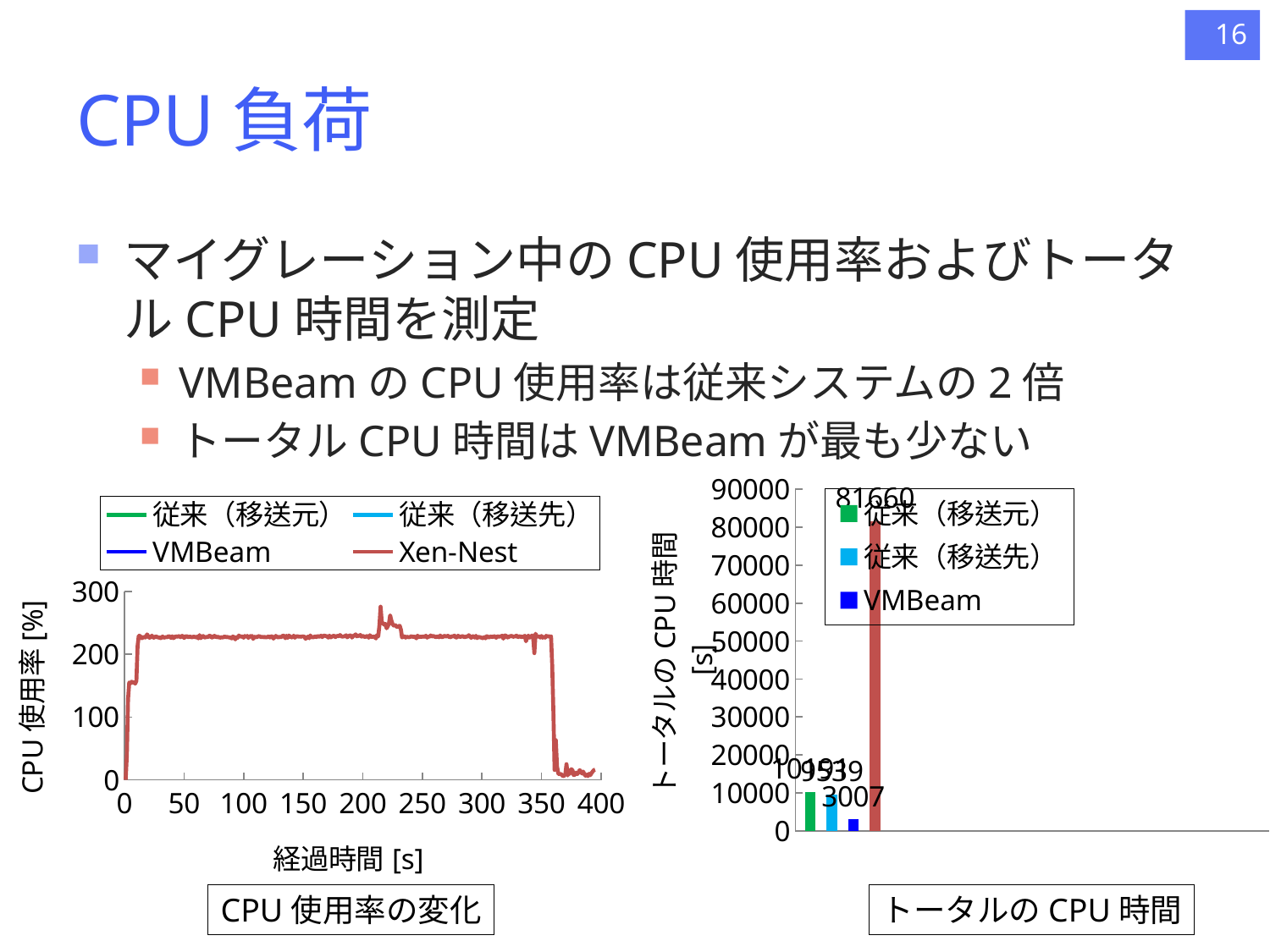
In the トータルの CPU 時間 chart, what is the difference between the tallest bar (81660) and the VMBeam bar (3007)? 78653 In the トータルの CPU 時間 chart, what is the largest value labelled on a bar? 81660 What kind of chart is the left-hand chart titled CPU 使用率の変化? line chart How many series does the legend of the トータルの CPU 時間 chart list? 3 In the トータルの CPU 時間 chart, which is larger, the value for 従来（移送先） or the value for VMBeam? 従来（移送先） What kind of chart is the right-hand chart titled トータルの CPU 時間? bar chart In the トータルの CPU 時間 chart, what is the value for VMBeam? 3007 What is the x-axis label of the CPU 使用率の変化 chart? 経過時間 [s] In the CPU 使用率の変化 chart, is the Xen-Nest CPU usage between 50 s and 300 s greater or less than 200? greater In the トータルの CPU 時間 chart, which series has the lowest total CPU time? VMBeam How many series does the legend of the CPU 使用率の変化 chart list? 4 In the トータルの CPU 時間 chart, is the value for VMBeam greater or less than 10000? less